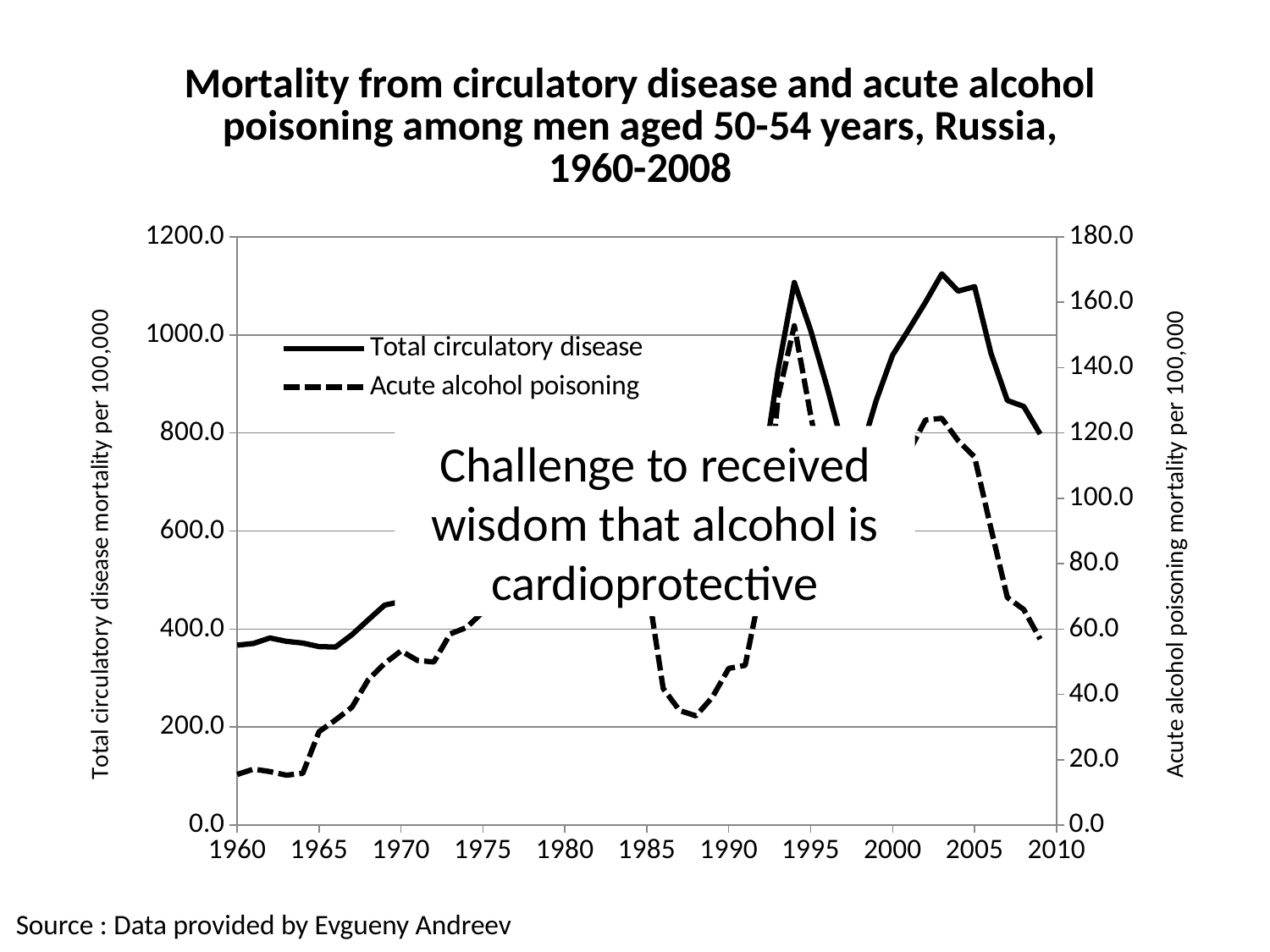
Is the value for Acute alcohol poisoning in 2003 greater or less than 100.0 on the right axis? greater Does the Total circulatory disease line rise or fall between 2005 and 2009? fall Which series is drawn with a dashed line? Acute alcohol poisoning Which is larger for Total circulatory disease: the value in 1960 or the value in 2003? 2003 What is the label of the right-hand vertical axis? Acute alcohol poisoning mortality per 100,000 Does the Acute alcohol poisoning line rise or fall between 1960 and 1970? rise Is the value for Total circulatory disease in 1960 greater or less than 600? less Is the value for Acute alcohol poisoning in 1988 greater or less than 40.0 on the right axis? less How many series does the chart's legend list? 2 What kind of chart is shown on the slide? line chart